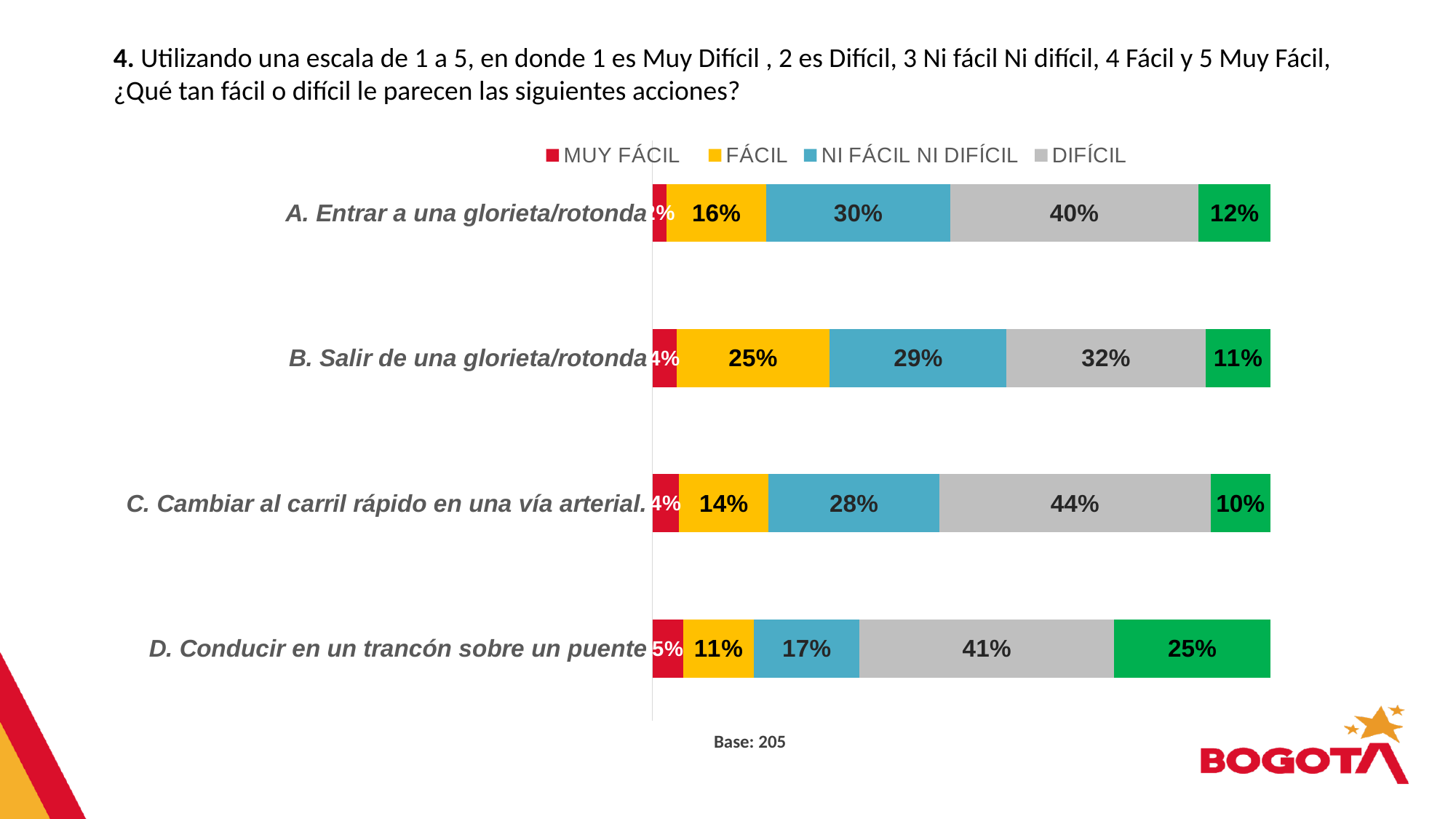
What is the NI FÁCIL NI DIFÍCIL value for 'C. Cambiar al carril rápido en una vía arterial.'? 28% What type of chart is shown on the slide? Stacked bar chart What is the base (number of respondents) shown below the chart? 205 Which has a larger FÁCIL value: 'A. Entrar a una glorieta/rotonda' or 'C. Cambiar al carril rápido en una vía arterial.'? A. Entrar a una glorieta/rotonda What percentage of respondents rated 'A. Entrar a una glorieta/rotonda' as DIFÍCIL? 40% What value is shown in the green segment for 'D. Conducir en un trancón sobre un puente'? 25% Which action has the lowest NI FÁCIL NI DIFÍCIL percentage? D. Conducir en un trancón sobre un puente How many series does the legend list? 4 How many actions (categories) are shown in the chart? 4 What is the FÁCIL value for 'B. Salir de una glorieta/rotonda'? 25% Which action has the highest DIFÍCIL (grey) percentage? C. Cambiar al carril rápido en una vía arterial. How many percentage points higher is the DIFÍCIL value for 'A. Entrar a una glorieta/rotonda' than for 'B. Salir de una glorieta/rotonda'? 8 percentage points